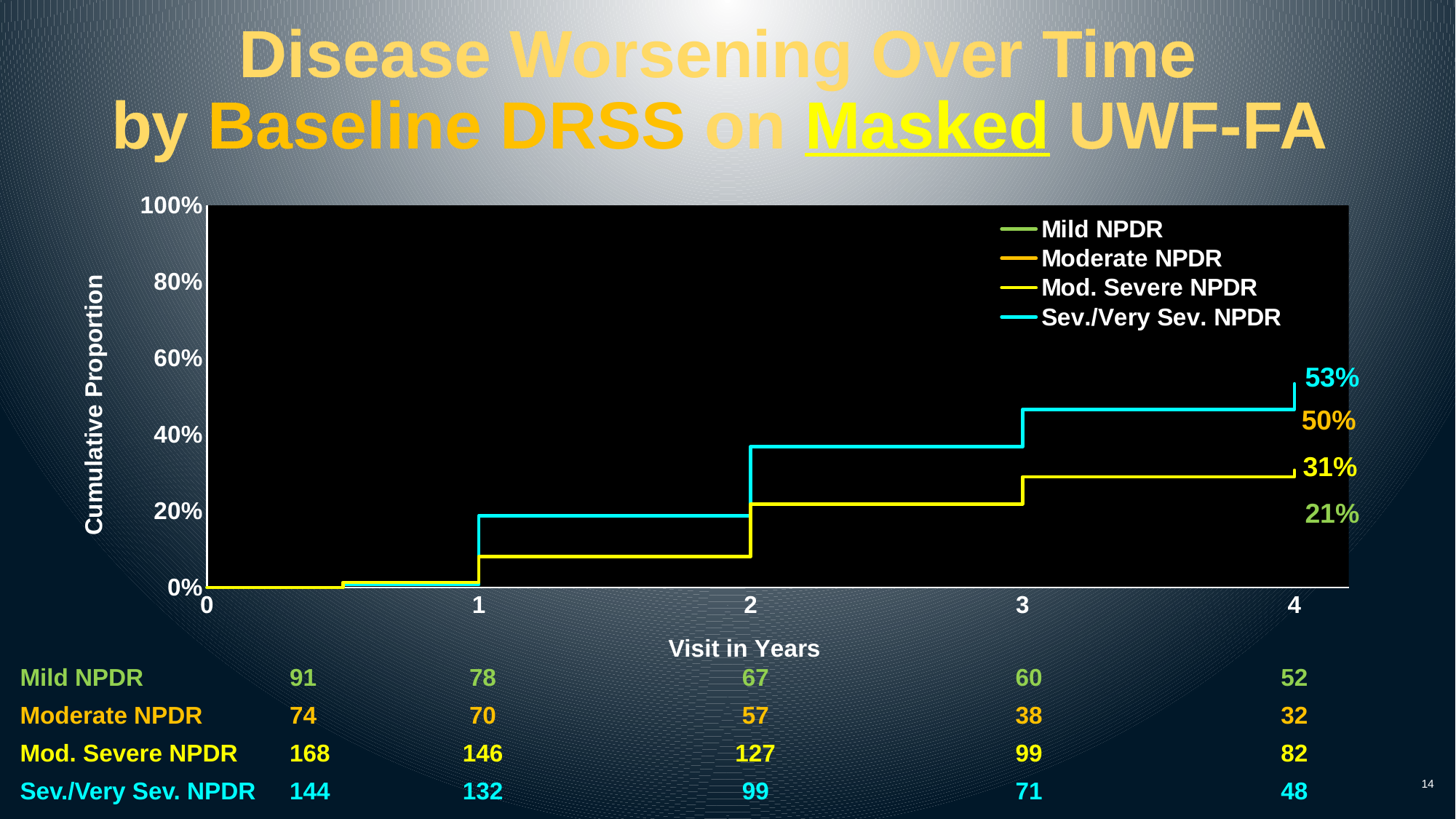
What is the difference between the year-4 values for Sev./Very Sev. NPDR and Mod. Severe NPDR? 22 percentage points Which baseline DRSS group has the highest cumulative proportion at year 4? Sev./Very Sev. NPDR Which baseline DRSS group has the lowest cumulative proportion at year 4? Mild NPDR How many series does the legend list? 4 What is the cumulative proportion labeled at year 4 for Mild NPDR? 21% Does the cumulative proportion for Sev./Very Sev. NPDR rise or fall along the x axis? rise What type of chart is shown on the slide? line chart What is the cumulative proportion labeled at year 4 for Sev./Very Sev. NPDR? 53% Which is larger at year 4: the value for Moderate NPDR or the value for Mod. Severe NPDR? Moderate NPDR What is the x-axis title of the chart? Visit in Years What is the cumulative proportion labeled at year 4 for Mod. Severe NPDR? 31%